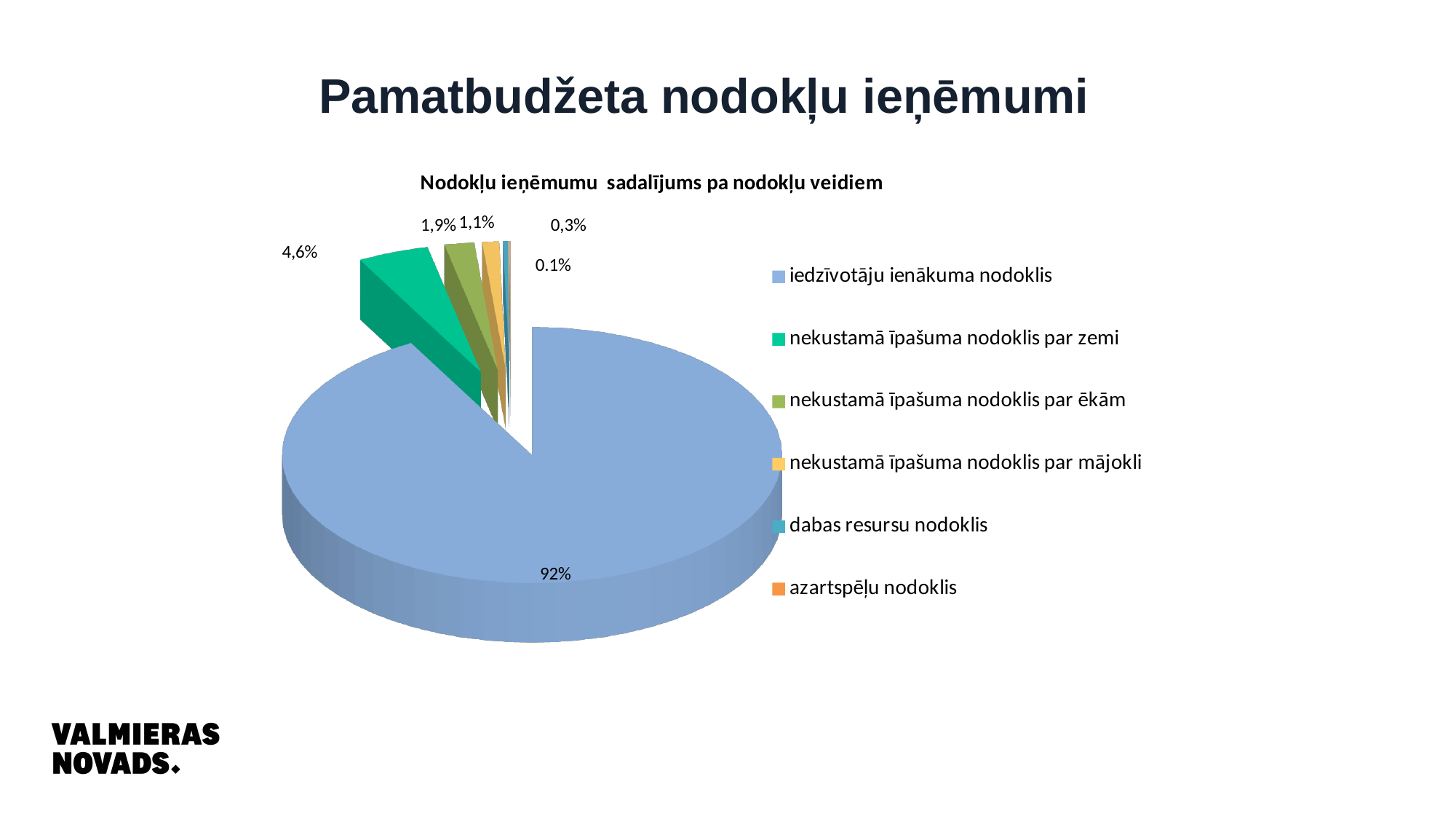
What share of the pie does nekustamā īpašuma nodoklis par zemi have? 4,6% What share of the pie does iedzīvotāju ienākuma nodoklis have? 92% What is the difference in percentage points between the slice for nekustamā īpašuma nodoklis par zemi and the slice for nekustamā īpašuma nodoklis par ēkām? 2,7 What share of the pie does dabas resursu nodoklis have? 0,3% Which category has the smallest slice of the pie? azartspēļu nodoklis Which category has the largest slice of the pie? iedzīvotāju ienākuma nodoklis How many categories does the legend of the pie chart list? 6 Which is larger: the slice for nekustamā īpašuma nodoklis par zemi or the slice for nekustamā īpašuma nodoklis par ēkām? nekustamā īpašuma nodoklis par zemi What is the title of the chart? Nodokļu ieņēmumu sadalījums pa nodokļu veidiem What kind of chart is shown on the slide? pie chart